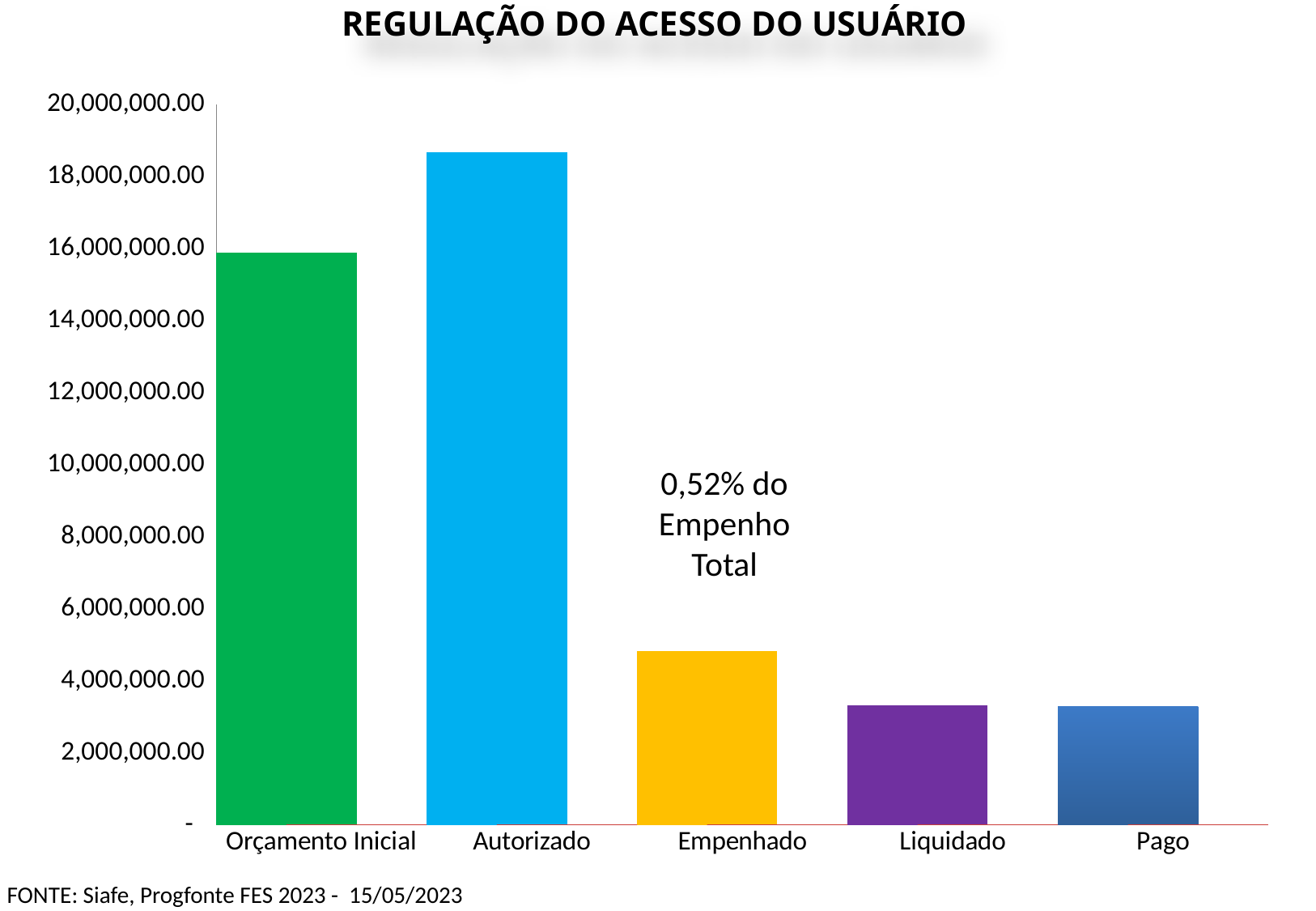
Is the value for Pago greater or less than 2,000,000.00? greater How many categories are shown on the x axis of the chart? 5 Is the value for Liquidado greater or less than 4,000,000.00? less Which is larger, the value for Orçamento Inicial or the value for Autorizado? Autorizado Is the value for Empenhado greater or less than 4,000,000.00? greater What text annotation is shown above the Empenhado bar? 0,52% do Empenho Total Which is larger, the value for Empenhado or the value for Liquidado? Empenhado Which category has the highest value in the chart? Autorizado What kind of chart is shown on the slide? bar chart What is the title of the chart? REGULAÇÃO DO ACESSO DO USUÁRIO